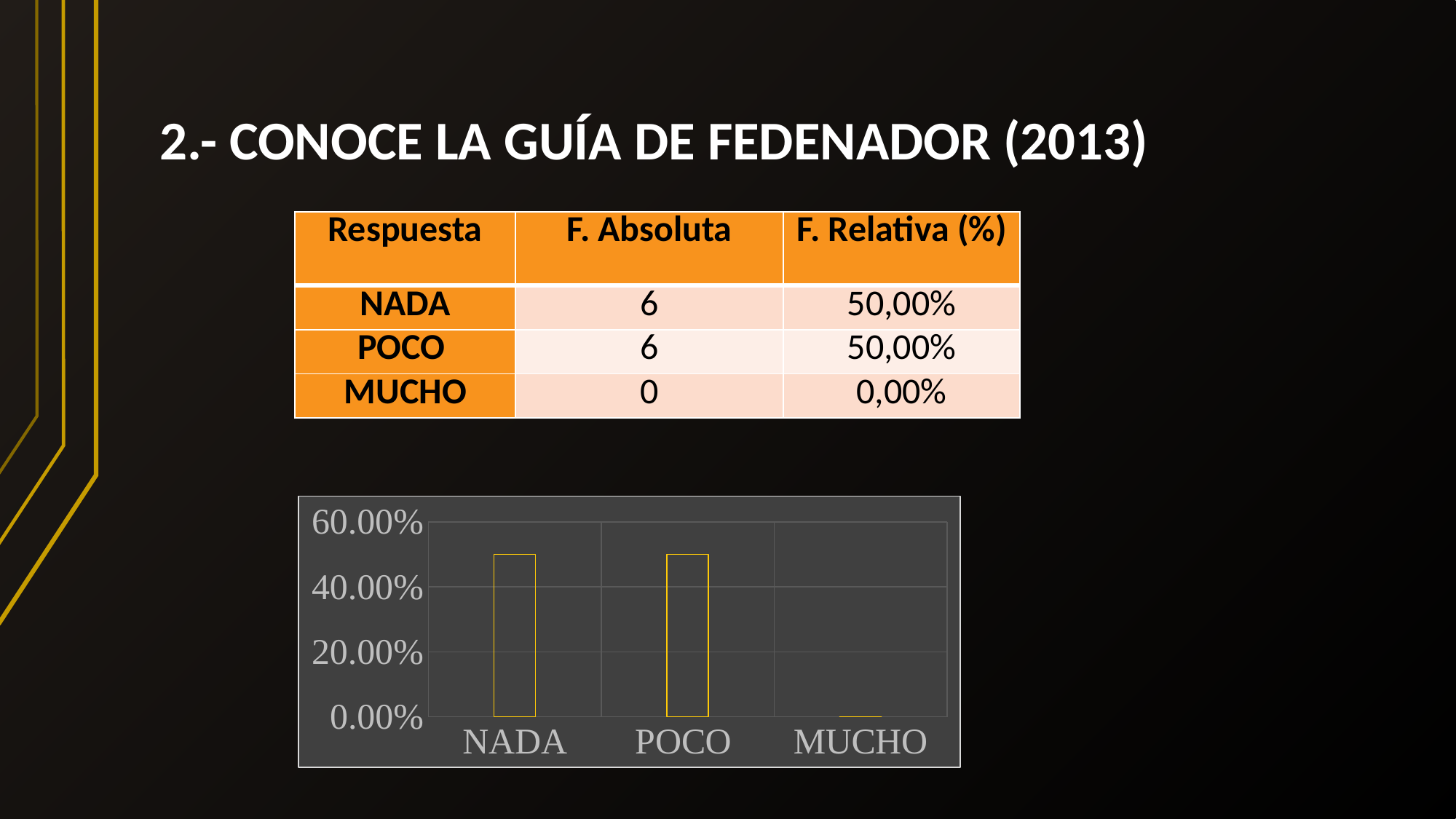
Do the values in the chart rise or fall from POCO to MUCHO? fall What is the value plotted for MUCHO in the chart? 0.00% According to the table, what is the F. Relativa (%) for NADA? 50,00% Which category has the lowest value in the chart? MUCHO Is the value for POCO in the chart greater or less than 60.00%? less According to the table, what is the F. Absoluta for POCO? 6 How many categories are shown on the x axis of the chart? 3 According to the table, what is the F. Absoluta for MUCHO? 0 Which is larger in the chart, the value for NADA or the value for MUCHO? NADA Is the value for NADA in the chart greater or less than 40.00%? greater What kind of chart is shown on the slide? bar chart What is the highest tick label on the chart's vertical axis? 60.00%